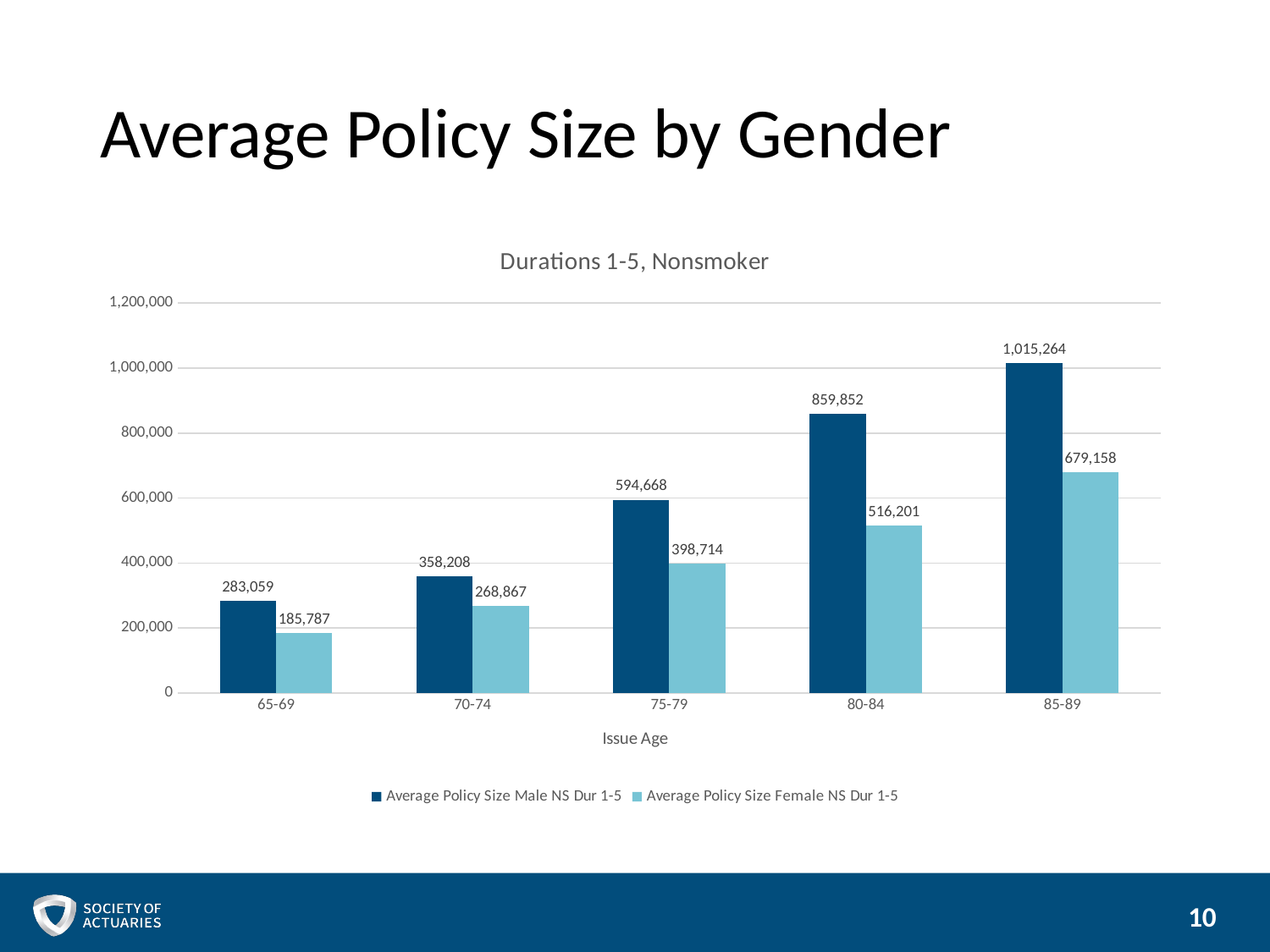
Do the Average Policy Size Male NS Dur 1-5 values rise or fall as issue age increases? Rise How many series does the legend list? 2 How many issue age groups are shown on the x axis? 5 For issue age 70-74, which is larger: the male or the female average policy size? Male What is the difference between the male and female average policy size for issue age 80-84? 343,651 Which issue age group has the highest Average Policy Size Male NS Dur 1-5? 85-89 Is the Average Policy Size Male NS Dur 1-5 for issue age 85-89 greater or less than 1,000,000? greater What is the Average Policy Size Female NS Dur 1-5 for issue age 65-69? 185,787 Which issue age group has the lowest Average Policy Size Female NS Dur 1-5? 65-69 What kind of chart is shown on the slide? Bar chart What is the Average Policy Size Female NS Dur 1-5 for issue age 85-89? 679,158 What is the Average Policy Size Male NS Dur 1-5 for issue age 75-79? 594,668